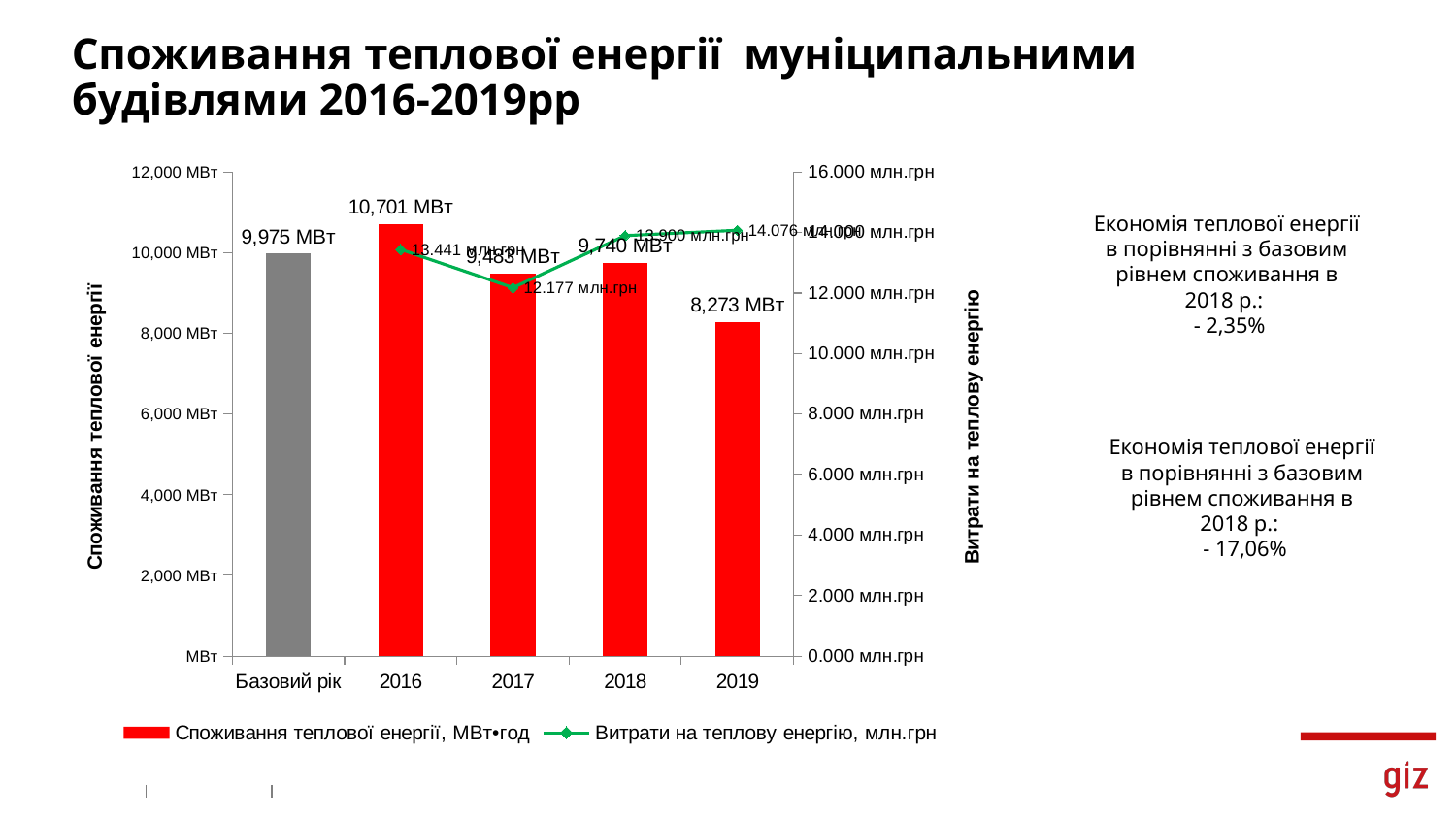
Which category has the lowest heat energy consumption bar? 2019 How many series does the chart legend list? 2 What is the difference between the heat energy consumption in 2016 and in 2019? 2,428 МВт What kind of chart is shown on the slide? A bar chart combined with a line chart How many categories are shown on the x axis of the chart? 5 What is the heat energy consumption value shown for 2019? 8,273 МВт In which year is the heat energy cost line at its lowest point? 2017 What is the heat energy cost (Витрати на теплову енергію) shown for 2017? 12.177 млн.грн What is the heat energy consumption value shown for the base year (Базовий рік)? 9,975 МВт Which year has higher heat energy consumption, 2017 or 2018? 2018 Which category has the highest heat energy consumption bar? 2016 What is the heat energy consumption value shown for 2016? 10,701 МВт